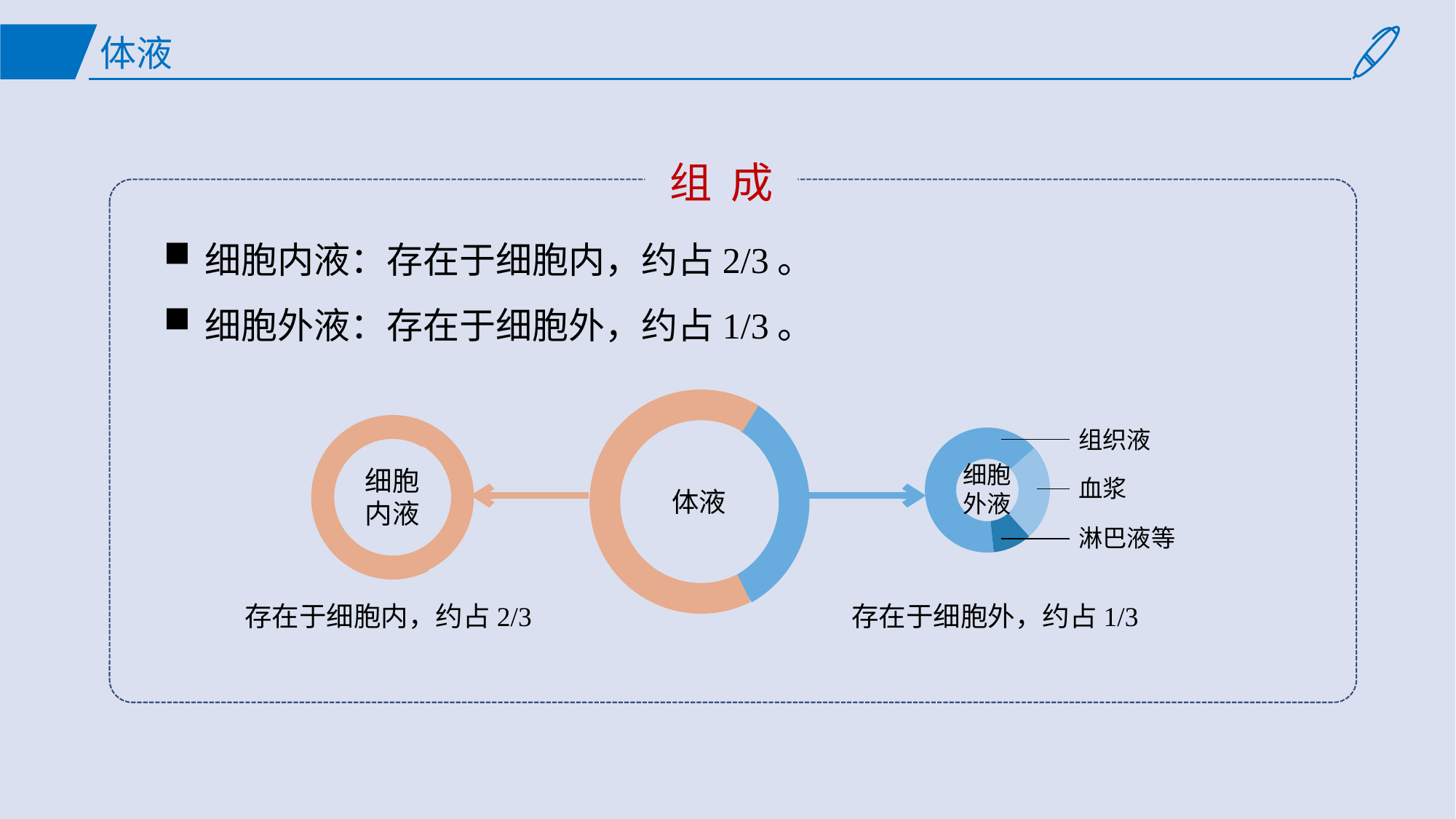
In the right-hand 细胞外液 chart, which segment is the largest? 组织液 What kind of chart is the central chart labelled 体液? donut chart What are the three components shown in the right-hand 细胞外液 chart? 组织液, 血浆, 淋巴液等 What is the label in the centre of the left-hand chart? 细胞内液 In the central 体液 chart, what share does 细胞外液 account for? 约占 1/3 In the central 体液 chart, what colour is the 细胞外液 segment? blue In the central 体液 chart, what share does 细胞内液 account for? 约占 2/3 How many segments does the right-hand 细胞外液 chart have? 3 How many segments does the central 体液 chart have? 2 In the central 体液 chart, which segment is larger, 细胞内液 or 细胞外液? 细胞内液 In the right-hand 细胞外液 chart, which segment is the smallest? 淋巴液等